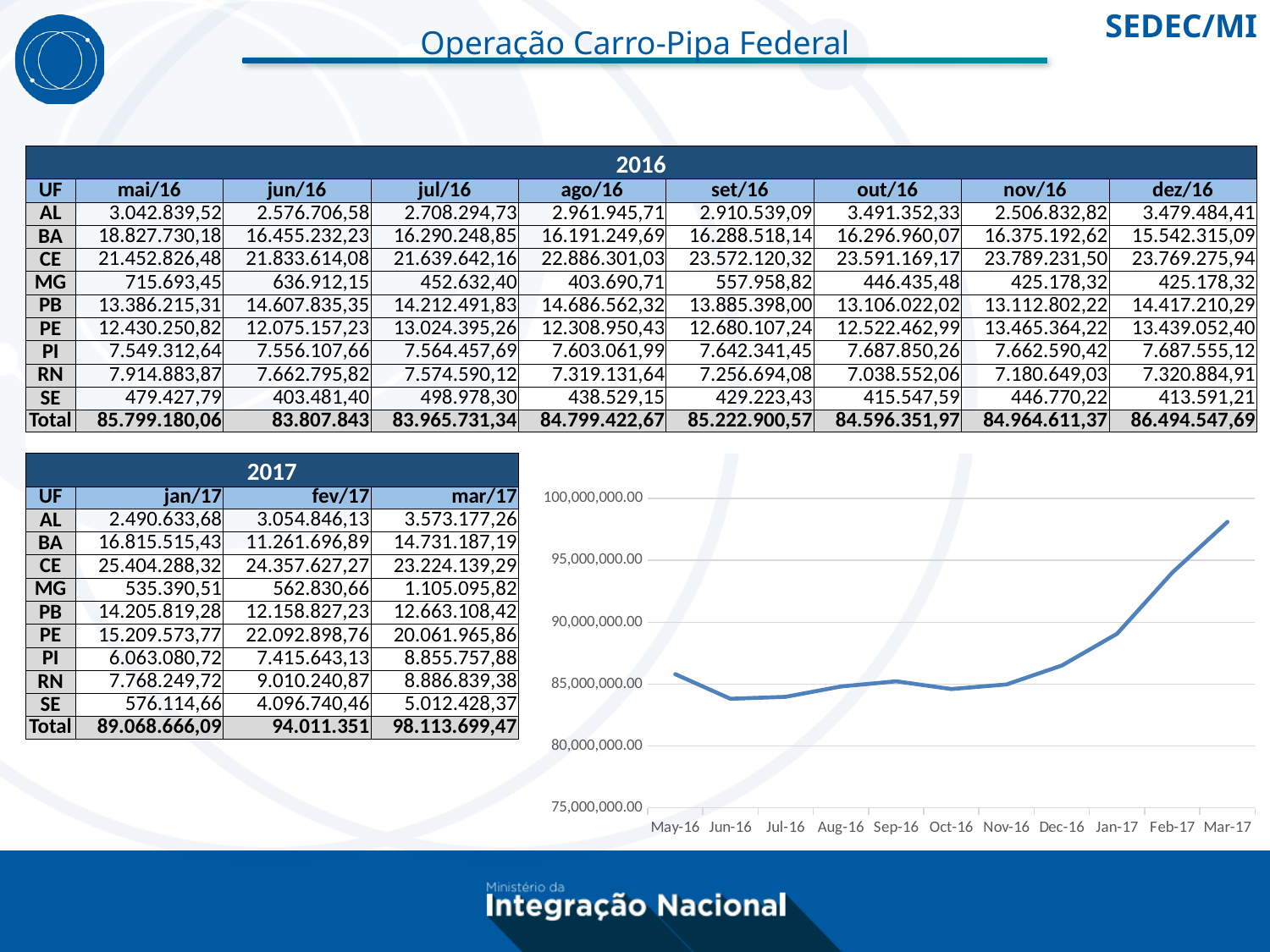
Which month has the highest value on the line chart? Mar-17 What is the lowest value shown on the y axis of the line chart? 75,000,000.00 Is the value for Jul-16 greater or less than 80,000,000.00? greater Is the value for Feb-17 greater or less than 90,000,000.00? greater Is the value for Jun-16 greater or less than 85,000,000.00? less Which is larger on the line chart, the value for Feb-17 or the value for Dec-16? Feb-17 Do the values on the line chart rise or fall from Dec-16 to Mar-17? Rise What kind of chart is shown on the slide? Line chart Which is larger on the line chart, the value for Mar-17 or the value for May-16? Mar-17 How many data points are plotted along the x axis of the line chart? 11